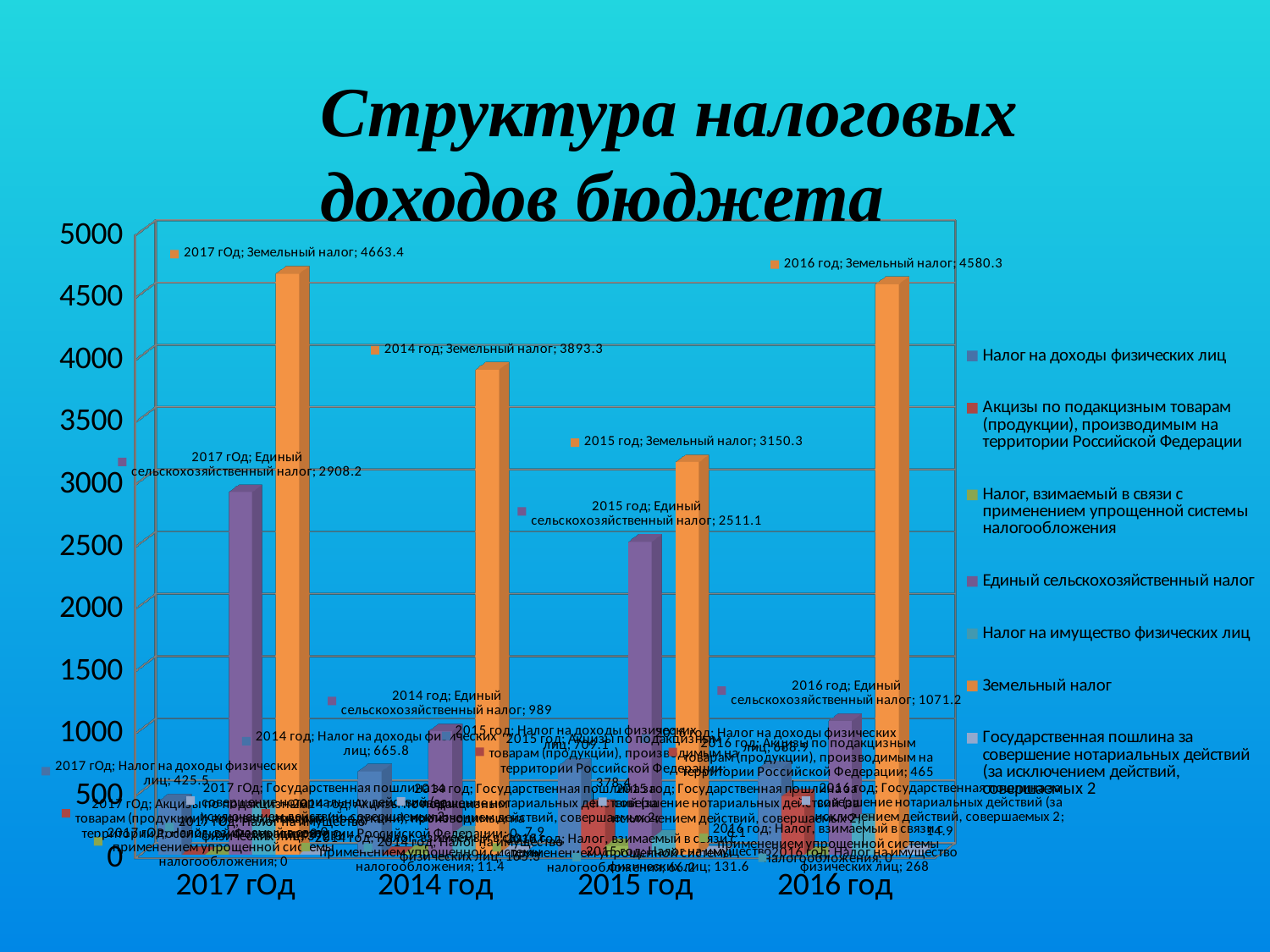
What is the difference between Земельный налог in 2017 гОд and in 2016 год? 83.1 What is the value of Земельный налог for 2017 гОд? 4663.4 What is the value of Единый сельскохозяйственный налог for 2017 гОд? 2908.2 How many series does the legend list? 7 In which year is Земельный налог the highest? 2017 гОд What is the value of Земельный налог for 2016 год? 4580.3 What is the value of Единый сельскохозяйственный налог for 2014 год? 989 How many year categories are shown on the x axis? 4 What kind of chart is shown on the slide? bar chart In which year is Земельный налог the lowest? 2015 год Which is larger: Единый сельскохозяйственный налог in 2017 гОд or in 2015 год? 2017 гОд Is the value of Земельный налог for 2014 год greater or less than 3500? greater